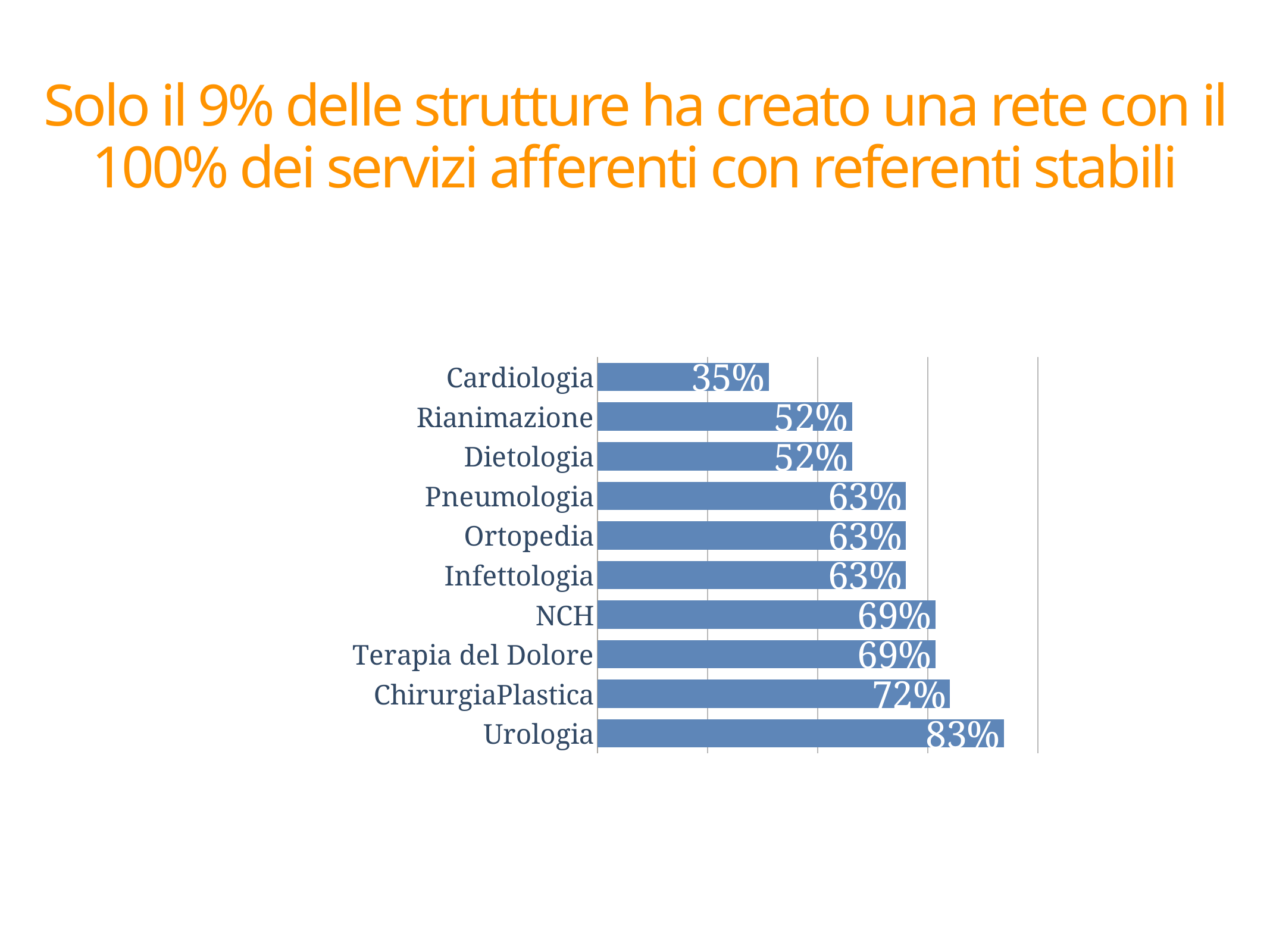
Which category has the highest value? Urologia Which category has the lowest value? Cardiologia What kind of chart is shown on the slide? Bar chart What is the value for Urologia? 83% What is the value for Terapia del Dolore? 69% Which is larger, the value for Rianimazione or the value for Infettologia? Infettologia What is the value for Cardiologia? 35% How many categories are shown in the chart? 10 What is the value for ChirurgiaPlastica? 72% What is the difference between the values for Urologia and Cardiologia? 48% What is the value for Pneumologia? 63% What is the difference between the values for ChirurgiaPlastica and NCH? 3%